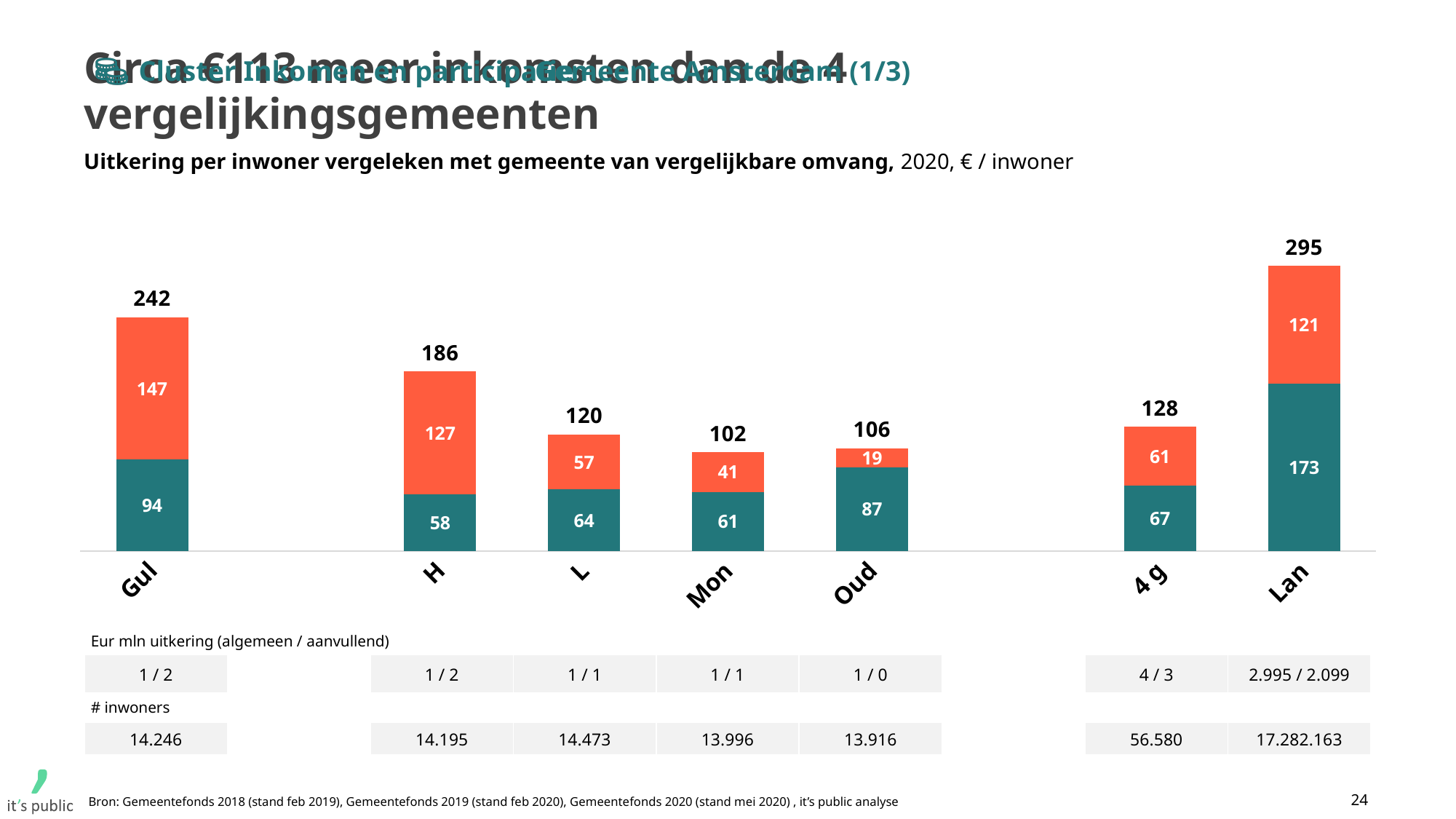
What is the total of the stacked bar for 4 g? 128 What is the total value shown above the bar for Gul? 242 What is the difference between the orange segment and the teal segment of the bar for Oud? 68 What is the value of the teal (bottom) segment of the bar for Lan? 173 Which has a larger total, Oud or Mon? Oud What kind of chart is shown on the slide? Stacked bar chart What unit is stated in the chart subtitle for the plotted values? € / inwoner How many categories (bars) are shown in the chart? 7 What is the difference between the total for Lan and the total for Gul? 53 Which category has the lowest total value? Mon Which category has the highest total value? Lan What is the value of the orange (top) segment of the bar for H? 127